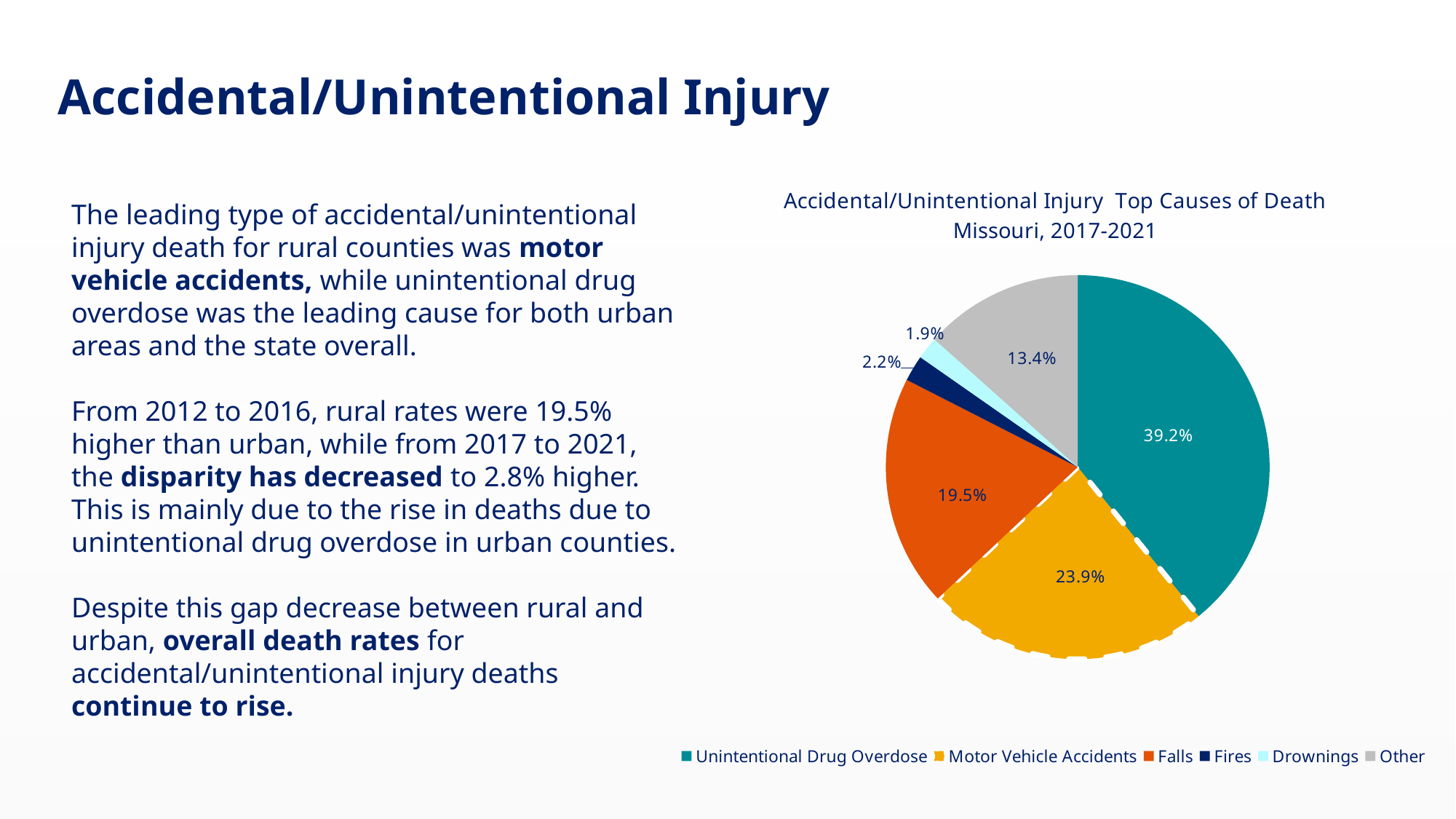
What share of the pie does Unintentional Drug Overdose represent? 39.2% How many slices does the pie chart have? 6 What is the value shown for Motor Vehicle Accidents? 23.9% What type of chart is shown on the slide? Pie chart Which cause of death has the largest slice of the pie? Unintentional Drug Overdose Which is larger, the share for Falls or the share for Other? Falls What percentage is shown for Falls? 19.5% What percentage is shown for Drownings? 1.9% What colour is the Fires slice in the pie chart? Dark navy blue Which cause of death has the smallest slice of the pie? Drownings What is the difference between the Unintentional Drug Overdose share and the Motor Vehicle Accidents share? 15.3% What is the title of the pie chart? Accidental/Unintentional Injury Top Causes of Death Missouri, 2017-2021